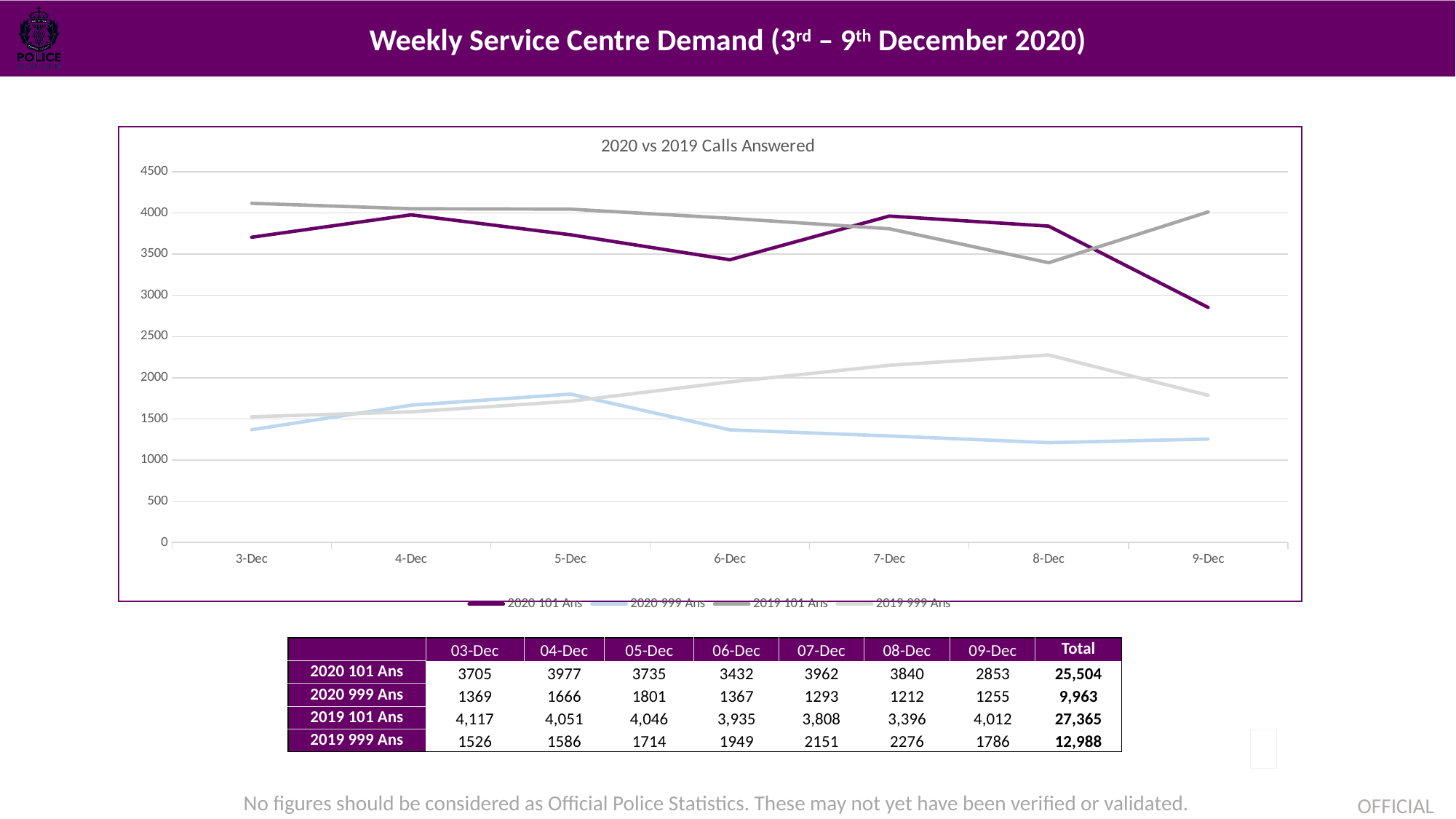
What kind of chart is shown on the slide? line chart What is the value for 2019 999 Ans on 8-Dec? 2276 How many series does the chart legend list? 4 How many dates are plotted along the x axis of the chart? 7 What is the value for 2020 101 Ans on 6-Dec? 3432 On which date is the 2020 101 Ans series at its lowest? 9-Dec Does the 2019 999 Ans series rise or fall from 3-Dec to 8-Dec? rise On which date is the 2020 999 Ans series at its highest? 5-Dec What is the difference between 2019 101 Ans and 2020 101 Ans on 3-Dec? 412 On 7-Dec, which is larger: 2020 101 Ans or 2019 101 Ans? 2020 101 Ans Is the value for 2019 101 Ans on 8-Dec greater or less than 3500? less What is the title of the chart? 2020 vs 2019 Calls Answered